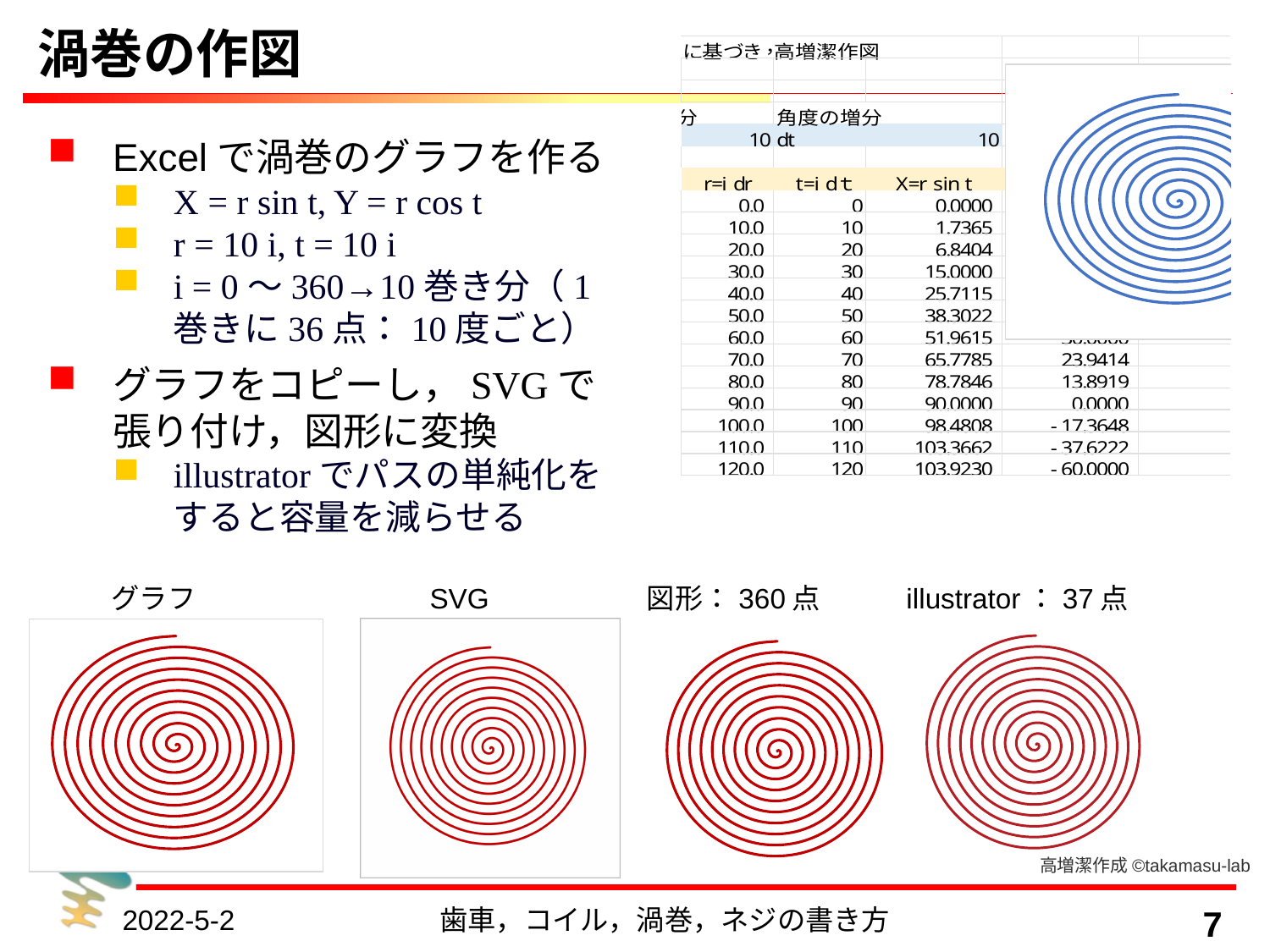
In the Excel table, what is the value of X=r sin t in the row where t=i dt is 90? 90.0000 What colour are the four spirals in the bottom row? red In the Excel table, what is the value of X=r sin t in the row where t=i dt is 120? 103.9230 How many more points does the 図形 spiral have than the illustrator spiral? 323 Of the labelled bottom spirals (図形 and illustrator), which has fewer points? illustrator How many spiral images are shown in the bottom row of the slide? 4 According to the label above the third bottom spiral (図形), how many points does it have? 360 点 What colour is the spiral in the Excel chart at the top right of the slide? blue What kind of chart is the Excel chart at the top right? a spiral line (scatter) chart In the Excel table, what is the value of X=r sin t in the row where r=i dr is 30.0? 15.0000 According to the label above the rightmost bottom spiral, how many points does the illustrator version have? 37 点 In the Excel table, which row has the larger X=r sin t value: t=100 or t=110? t=110